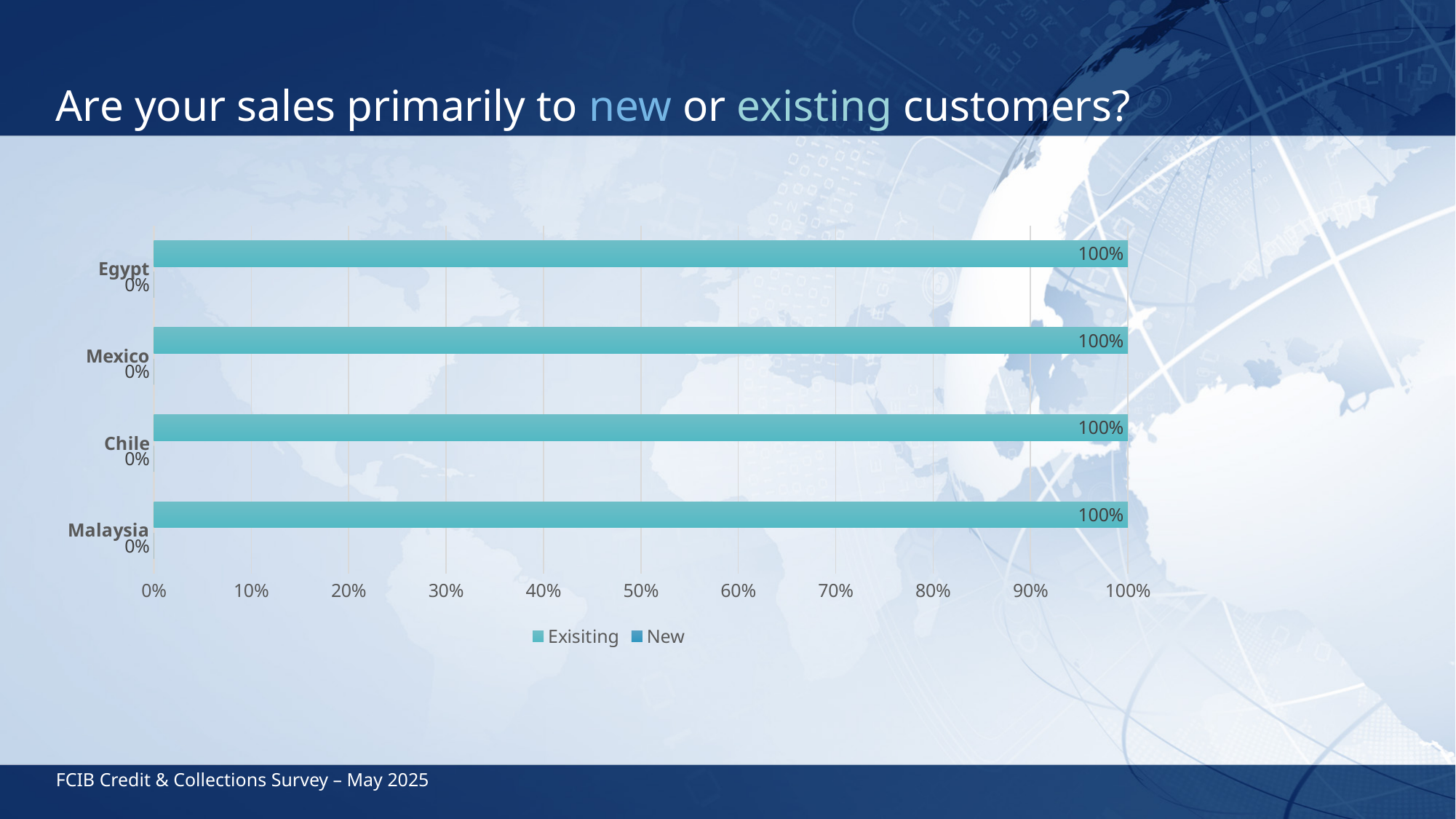
How many countries are shown on the chart? 4 For Egypt, which is larger, the Existing value or the New value? Existing What is the New value for Malaysia? 0% Which country is listed at the top of the chart? Egypt What is the difference between the Existing and New values for Chile? 100% What is the New value for Mexico? 0% What is the Existing value for Egypt? 100% What kind of chart is shown on the slide? bar chart Is the Existing value for Malaysia greater or less than 50%? greater How many series does the legend list? 2 What is the Existing value for Chile? 100%